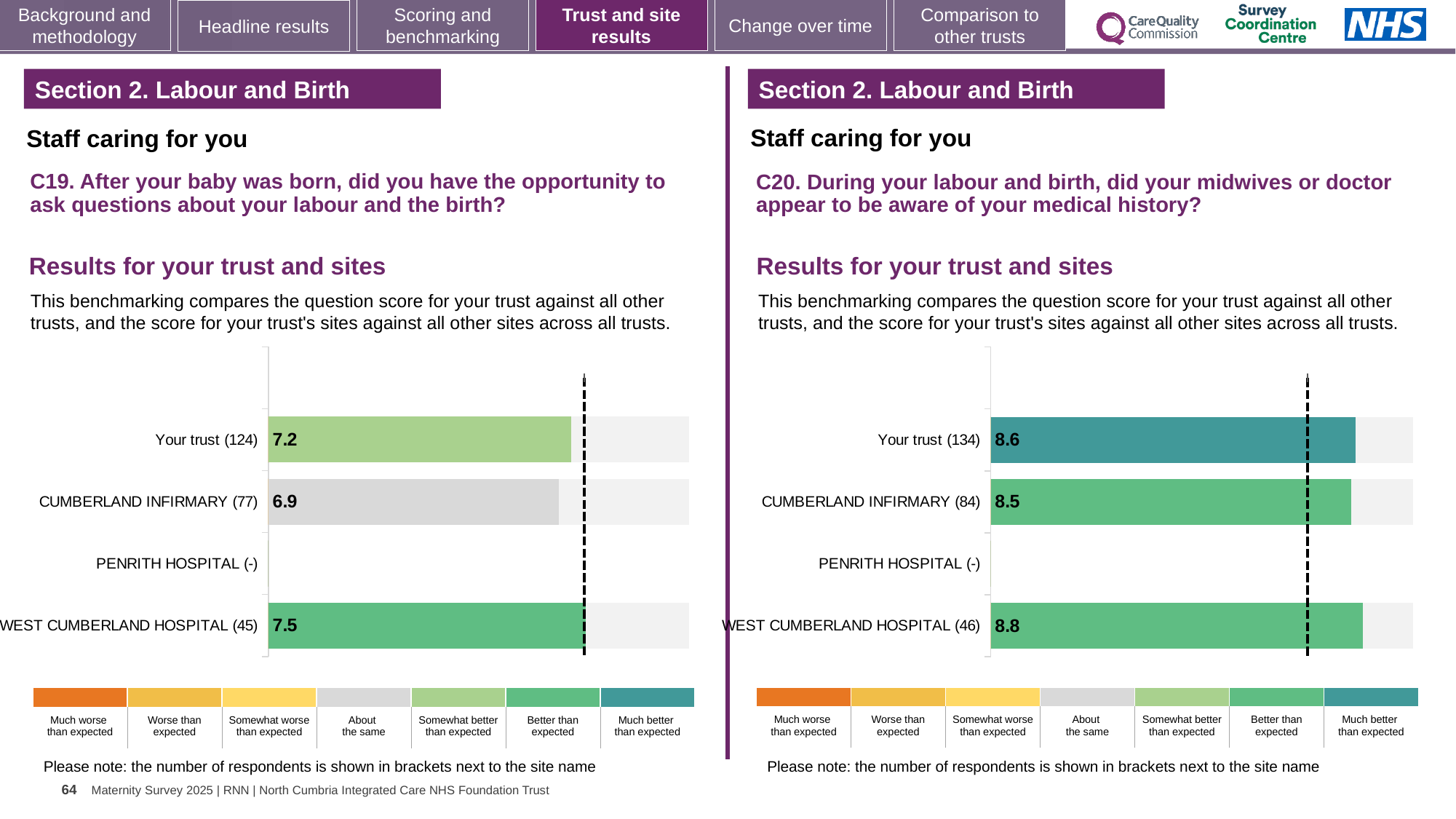
What kind of chart is used on the left for the C19 results? Bar chart In the C20 chart on the right, what is the difference between the scores for WEST CUMBERLAND HOSPITAL and Your trust? 0.2 In the C19 chart on the left, what is the score for Your trust? 7.2 In the C20 chart on the right, which has the higher score, Your trust or CUMBERLAND INFIRMARY? Your trust In the C20 chart on the right, what is the score for WEST CUMBERLAND HOSPITAL? 8.8 In the C20 chart on the right, which site or trust has the lowest score shown? CUMBERLAND INFIRMARY In the C19 chart on the left, what is the score for WEST CUMBERLAND HOSPITAL? 7.5 In the C19 chart on the left, what is the score for CUMBERLAND INFIRMARY? 6.9 In the C19 chart on the left, what is the difference between the scores for WEST CUMBERLAND HOSPITAL and CUMBERLAND INFIRMARY? 0.6 In the C19 chart on the left, how many respondents are shown in brackets for Your trust? 124 In the C20 chart on the right, what is the score for Your trust? 8.6 In the C19 chart on the left, which site or trust has the highest score? WEST CUMBERLAND HOSPITAL